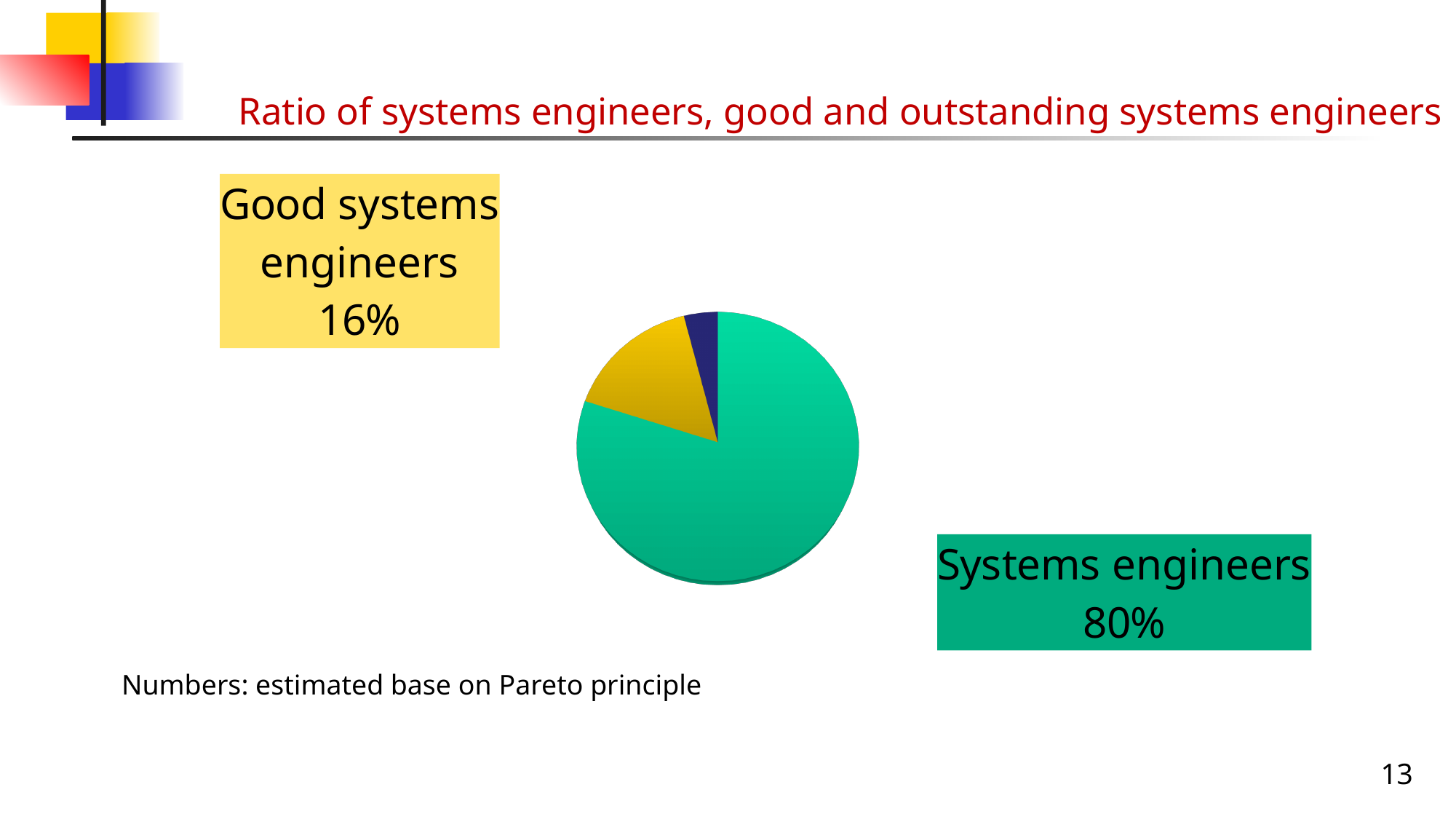
What kind of chart is shown on the slide? Pie chart What is the difference in percentage points between the Systems engineers share and the Good systems engineers share? 64 percentage points How many slices does the pie chart have? 3 What is the value shown for Good systems engineers? 16% What share of the pie do Systems engineers represent? 80% What is the title of the slide containing the pie chart? Ratio of systems engineers, good and outstanding systems engineers What colour is the slice representing Systems engineers? Green Which is larger, the share for Systems engineers or the share for Good systems engineers? Systems engineers Which labelled category has the largest slice of the pie? Systems engineers